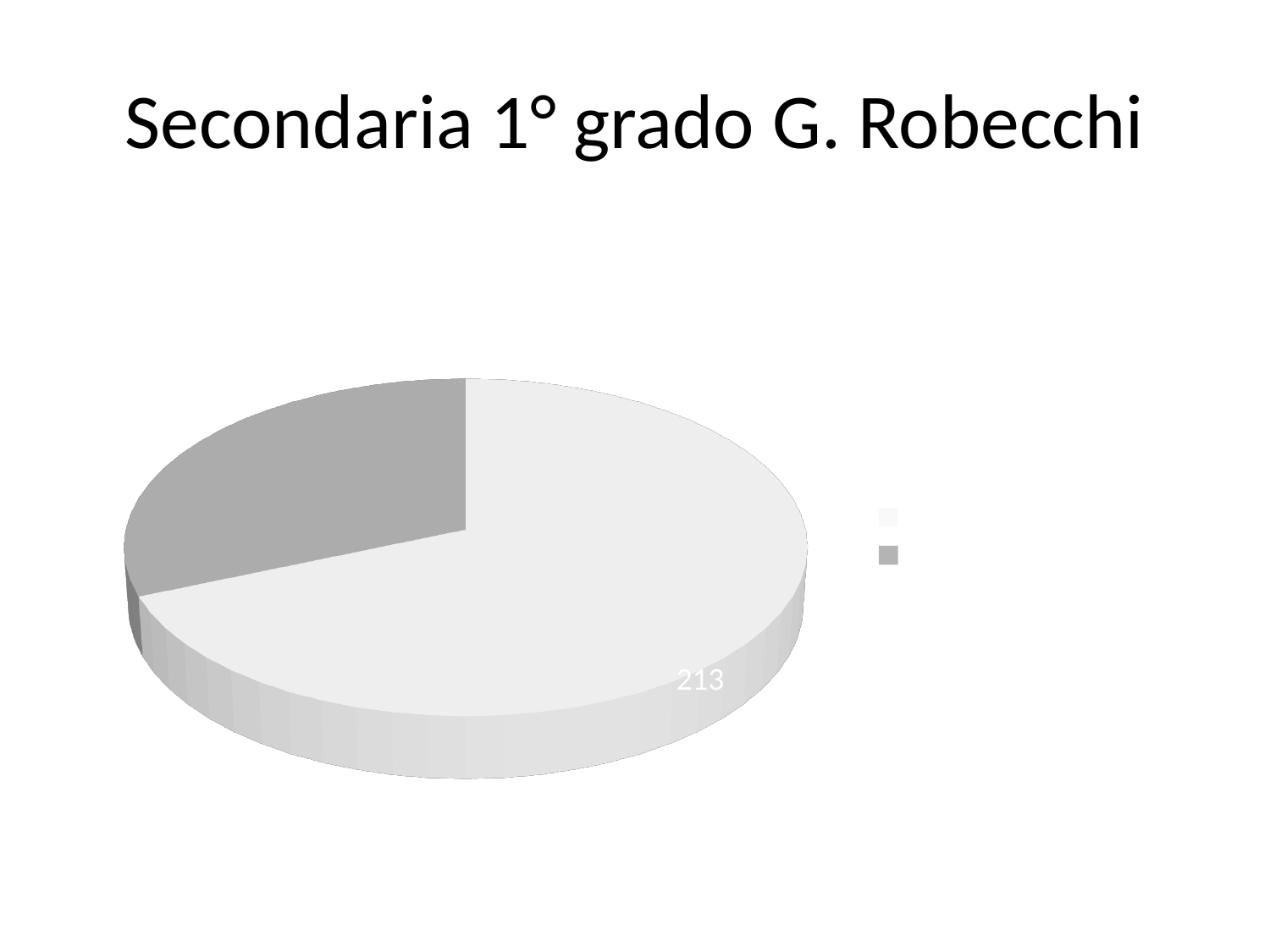
Which slice is larger, the light grey slice or the dark grey slice? the light grey slice Which slice of the pie chart is the smallest? the dark grey slice Is the light grey slice more or less than half of the pie? more What kind of chart is shown on the slide? pie chart What is the title of the chart on the slide? Secondaria 1° grado G. Robecchi How many entries does the legend list? 2 What value is printed on the large light grey slice of the pie chart? 213 How many slices does the pie chart have? 2